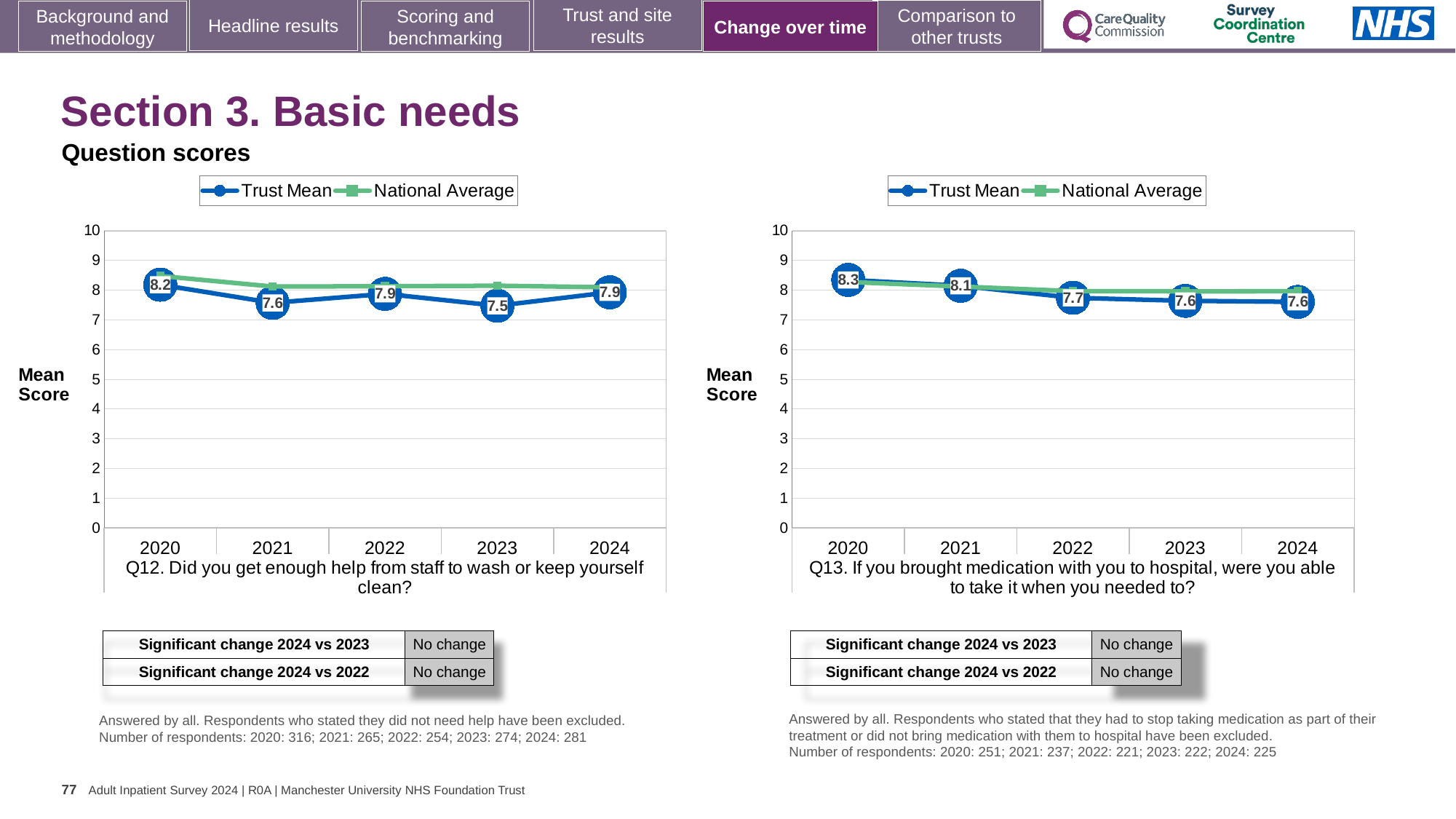
In the Q13 chart on the right, which year has the highest Trust Mean score? 2020 What kind of chart is the Q12 chart on the left? line chart How many years are plotted on the x axis of the Q12 chart on the left? 5 In the Q12 chart on the left, which year has the lowest Trust Mean score? 2023 In the Q13 chart on the right, does the Trust Mean generally rise or fall from 2020 to 2024? fall In the Q13 chart on the right, what is the Trust Mean score for 2022? 7.7 In the Q12 chart on the left, which year has the higher Trust Mean score, 2021 or 2022? 2022 In the Q12 chart on the left, what is the Trust Mean score for 2020? 8.2 How many series does the legend of the Q13 chart on the right list? 2 In the Q13 chart on the right, what is the difference between the Trust Mean scores for 2020 and 2024? 0.7 In the Q12 chart on the left, what is the difference between the Trust Mean scores for 2020 and 2023? 0.7 In the Q13 chart on the right, is the National Average value for 2020 greater or less than 8? greater